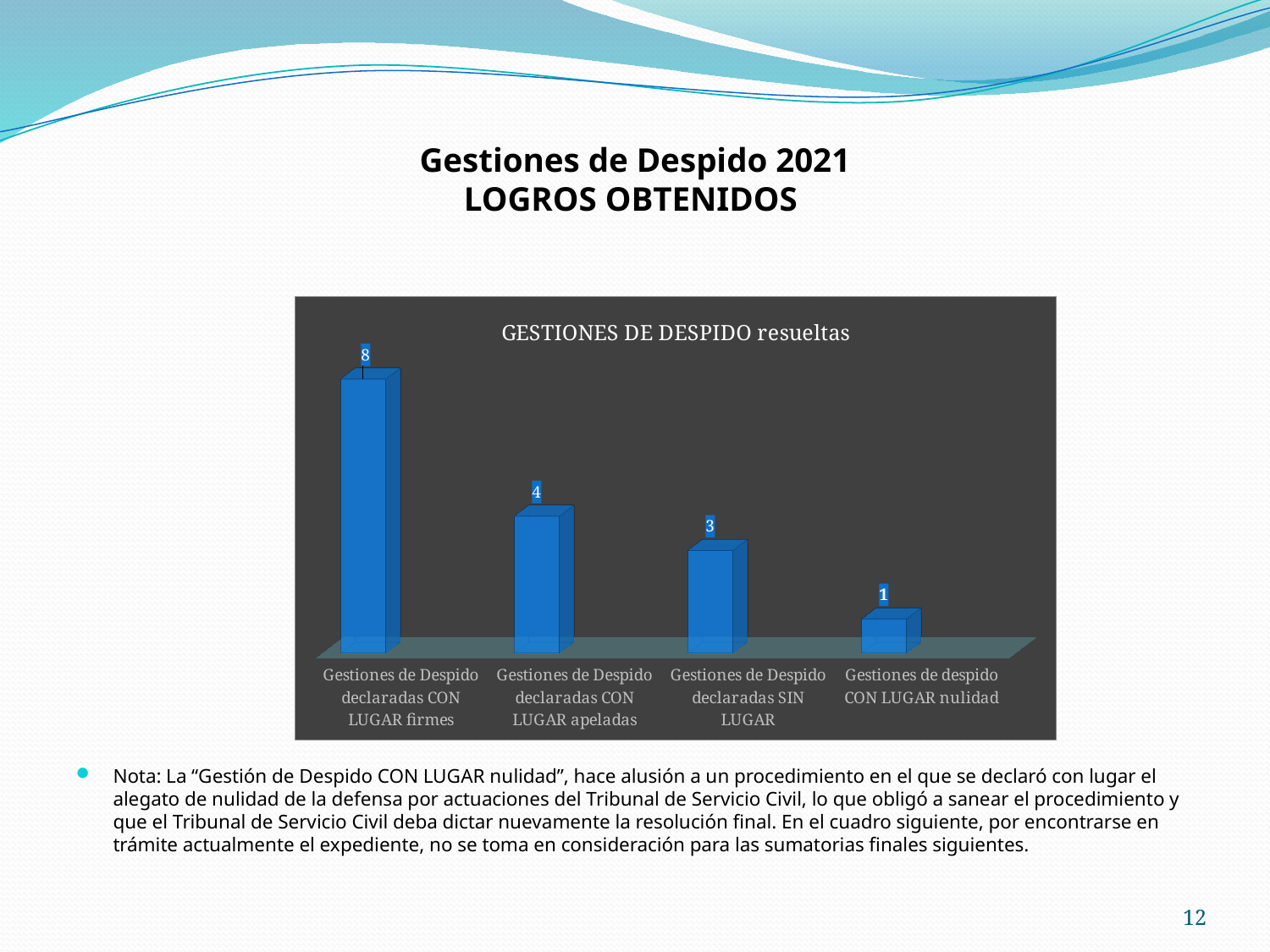
Do the values rise or fall from left to right across the categories? Fall What is the value for Gestiones de despido CON LUGAR nulidad? 1 Which is larger: the value for Gestiones de Despido declaradas CON LUGAR apeladas or the value for Gestiones de Despido declaradas SIN LUGAR? Gestiones de Despido declaradas CON LUGAR apeladas Which category has the lowest value? Gestiones de despido CON LUGAR nulidad What is the value for Gestiones de Despido declaradas CON LUGAR firmes? 8 What is the difference between the values for Gestiones de Despido declaradas CON LUGAR firmes and Gestiones de Despido declaradas CON LUGAR apeladas? 4 What is the value for Gestiones de Despido declaradas CON LUGAR apeladas? 4 What is the title of the chart? GESTIONES DE DESPIDO resueltas How many categories are shown in the chart? 4 What is the value for Gestiones de Despido declaradas SIN LUGAR? 3 Which category has the highest value? Gestiones de Despido declaradas CON LUGAR firmes What kind of chart is shown on the slide? Bar chart